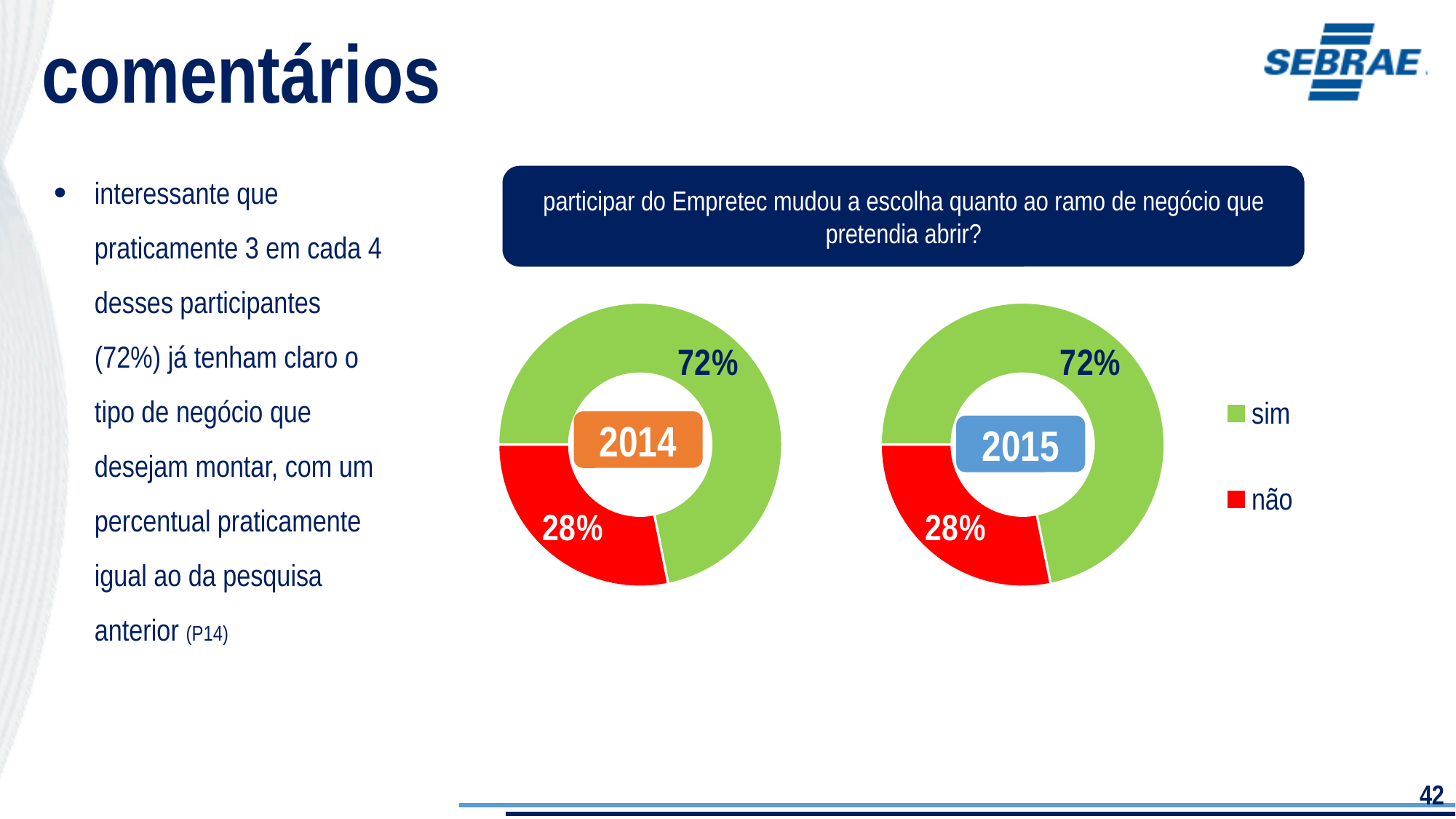
How many entries does the legend list? 2 In the 2014 chart, what is the difference between the "sim" and "não" shares? 44% Which colour represents "não" in the charts? Red In the 2015 chart, which category has the largest share? sim How many categories does the 2014 chart show? 2 In the 2015 chart, what percentage answered "sim"? 72% In the 2015 chart, what percentage answered "não"? 28% In the 2014 chart, what percentage answered "sim"? 72% In the 2014 chart, what percentage answered "não"? 28% In the 2014 chart, which category has the smallest share? não What kind of chart is the 2015 chart? Doughnut (pie) chart In the 2015 chart, which is larger, the "sim" share or the "não" share? sim